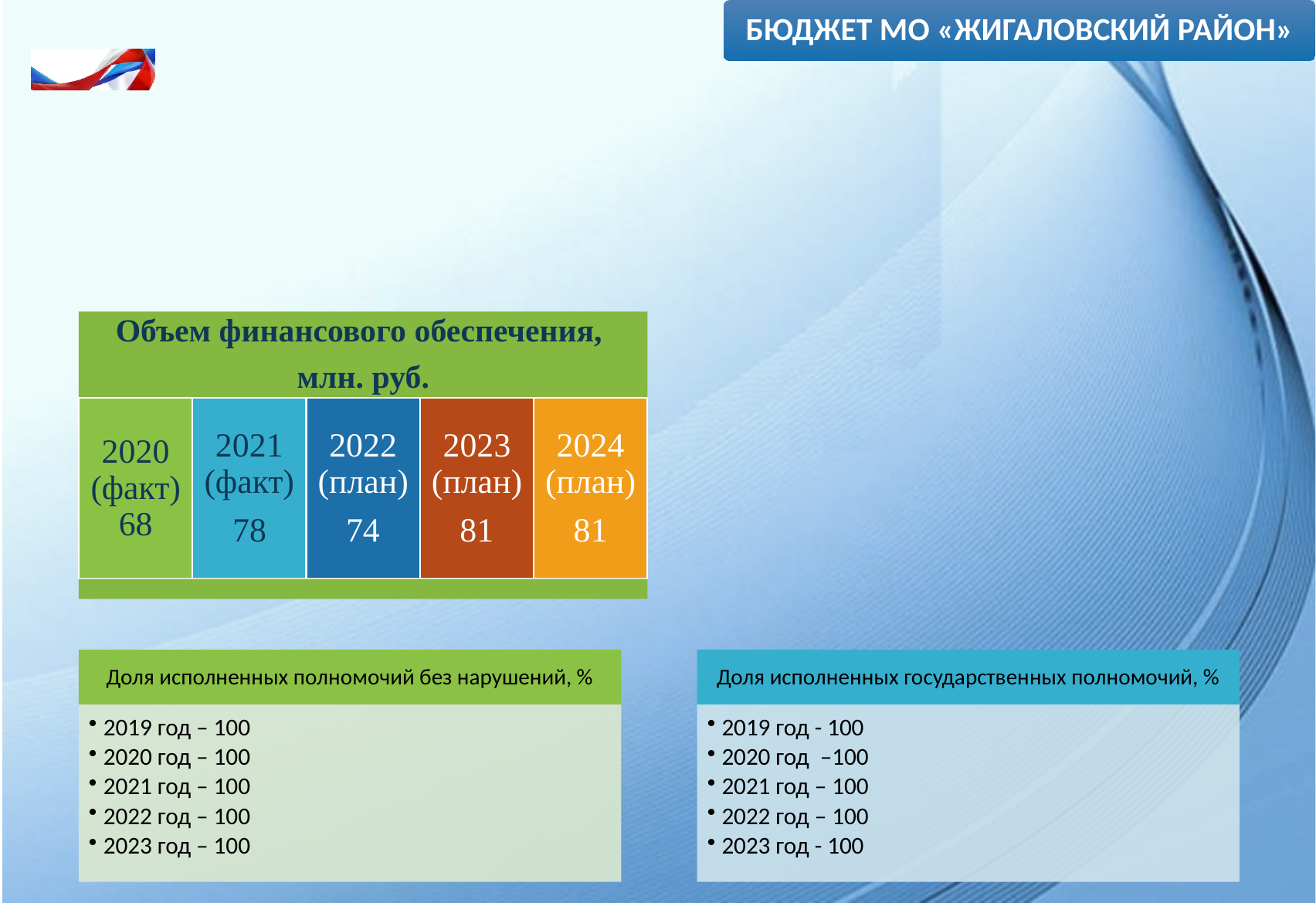
In the 'Объем финансового обеспечения, млн. руб.' block, what is the value for 2022 (план)? 74 In the 'Объем финансового обеспечения, млн. руб.' block, what is the difference between the 2021 (факт) value and the 2020 (факт) value? 10 In the 'Объем финансового обеспечения, млн. руб.' block, what is the difference between the 2023 (план) value and the 2022 (план) value? 7 In the 'Объем финансового обеспечения, млн. руб.' block, which is larger: the value for 2021 (факт) or the value for 2022 (план)? 2021 (факт) In the 'Объем финансового обеспечения, млн. руб.' block, what is the value for 2024 (план)? 81 In the 'Объем финансового обеспечения, млн. руб.' block, what colour is the 2023 (план) cell? Brown (dark orange) In the 'Объем финансового обеспечения, млн. руб.' block, how many years are marked as (план)? 3 In the 'Объем финансового обеспечения, млн. руб.' block, what is the value for 2021 (факт)? 78 How many years are shown in the 'Объем финансового обеспечения, млн. руб.' block? 5 What unit is given in the title of the 'Объем финансового обеспечения' block? млн. руб. In the 'Объем финансового обеспечения, млн. руб.' block, what is the value for 2020 (факт)? 68 In the 'Объем финансового обеспечения, млн. руб.' block, which year has the lowest value? 2020 (факт)